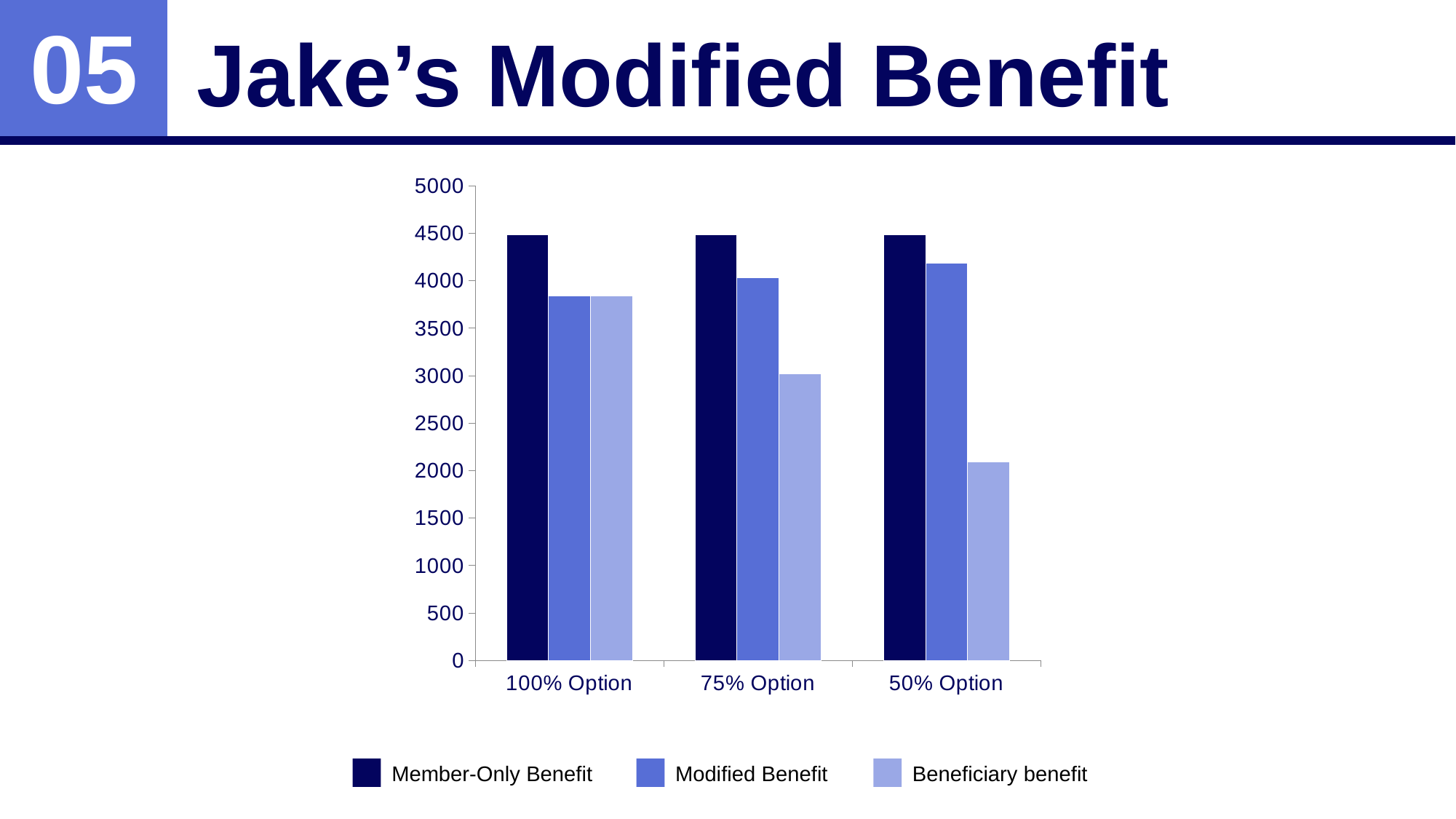
Is the Beneficiary benefit value for the 50% Option greater or less than 2500? less For the 100% Option, which is larger: the Member-Only Benefit or the Modified Benefit? Member-Only Benefit Is the Member-Only Benefit value for the 100% Option greater or less than 4000? greater Which series is shown in the darkest colour in the chart? Member-Only Benefit How many series does the chart's legend list? 3 How many categories are shown on the x axis of the chart? 3 What is the title of the slide containing the chart? Jake's Modified Benefit Does the Beneficiary benefit rise or fall moving from the 100% Option to the 50% Option? fall For the 50% Option, which is larger: the Modified Benefit or the Beneficiary benefit? Modified Benefit Which option has the lowest Beneficiary benefit? 50% Option Is the Modified Benefit value for the 100% Option greater or less than 4000? less What kind of chart is shown on the slide? bar chart